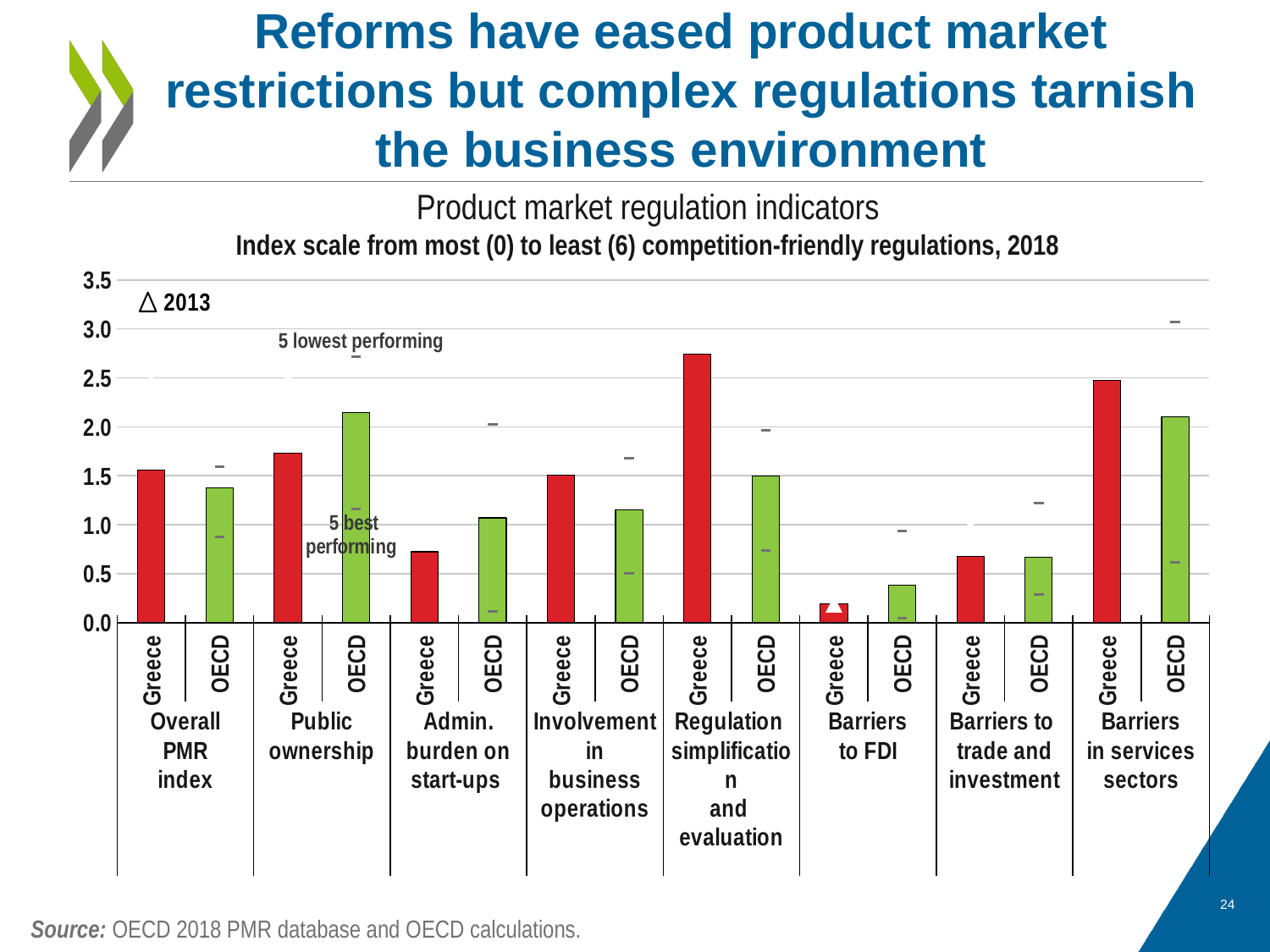
Is the Greece value for Admin. burden on start-ups greater or less than 1.0? less How many indicator categories are shown along the x axis of the chart? 8 For Regulation simplification and evaluation, which bar is taller, Greece or OECD? Greece What is the title of the chart? Product market regulation indicators In which category is the Greece bar the lowest? Barriers to FDI Is the OECD value for Public ownership greater or less than 2.0? greater What kind of chart is shown on the slide? Bar chart For Public ownership, which bar is taller, Greece or OECD? OECD Is the Greece value for Barriers in services sectors greater or less than 2.0? greater What year does the triangle marker in the chart represent? 2013 In which category is the Greece bar the highest? Regulation simplification and evaluation